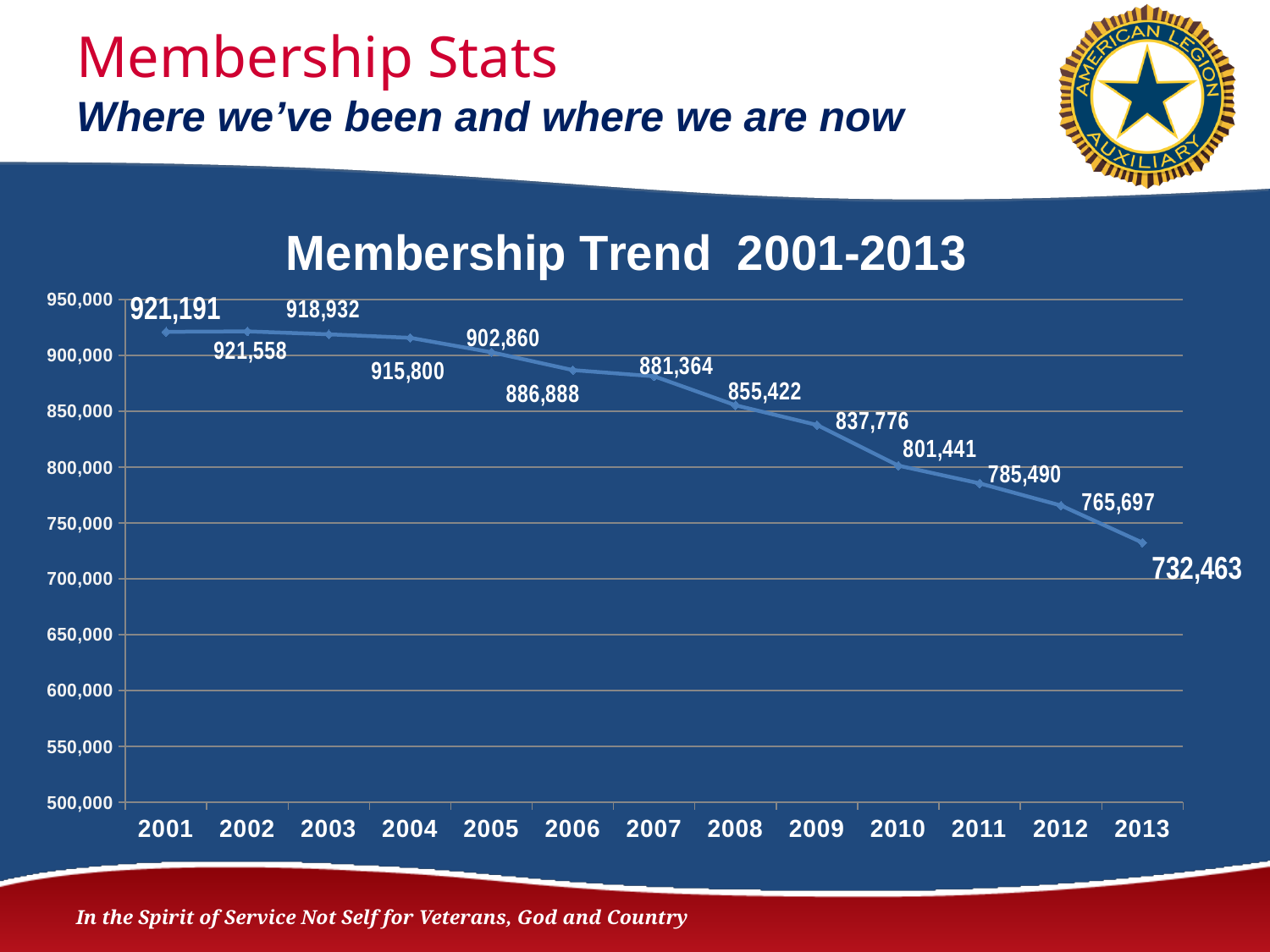
What kind of chart is shown on the slide? line chart How many years are plotted on the chart? 13 What was the membership value in 2013? 732,463 Is the membership value for 2013 greater or less than 750,000? less Which year has the highest membership value? 2002 What is the difference between the membership values in 2012 and 2013? 33,234 Which year has the lowest membership value? 2013 What is the difference between the membership values in 2001 and 2013? 188,728 What was the membership value in 2007? 881,364 What was the membership value in 2001? 921,191 Which is larger, the membership value in 2005 or in 2008? 2005 Do the membership values rise or fall from 2001 to 2013? fall